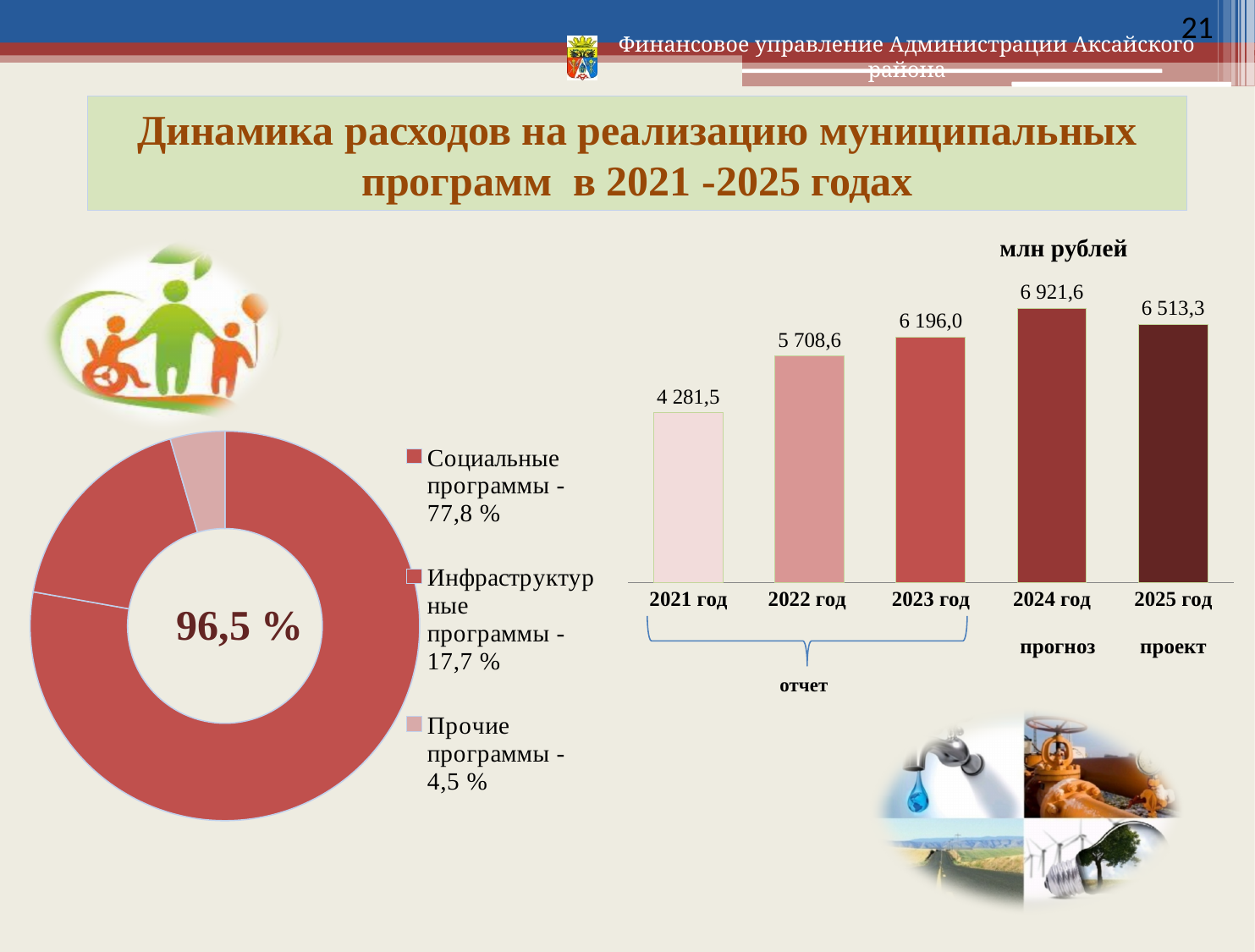
In the bar chart on the right, which is larger: the value for 2023 год or the value for 2025 год? 2025 год In the bar chart on the right, what is the difference between the values for 2022 год and 2021 год? 1 427,1 In the bar chart on the right, which year has the lowest value? 2021 год In the bar chart on the right, which year has the highest value? 2024 год In the doughnut chart on the left, which category has the smallest share? Прочие программы How many bars are shown in the bar chart on the right? 5 In the doughnut chart on the left, what share do Социальные программы have? 77,8 % In the bar chart on the right, what is the value for 2025 год? 6 513,3 In the bar chart on the right, what is the value for 2024 год? 6 921,6 What type of chart is shown on the left side of the slide? Doughnut (pie) chart In the bar chart on the right, what is the value for 2021 год? 4 281,5 In the bar chart on the right, what is the difference between the values for 2024 год and 2025 год? 408,3